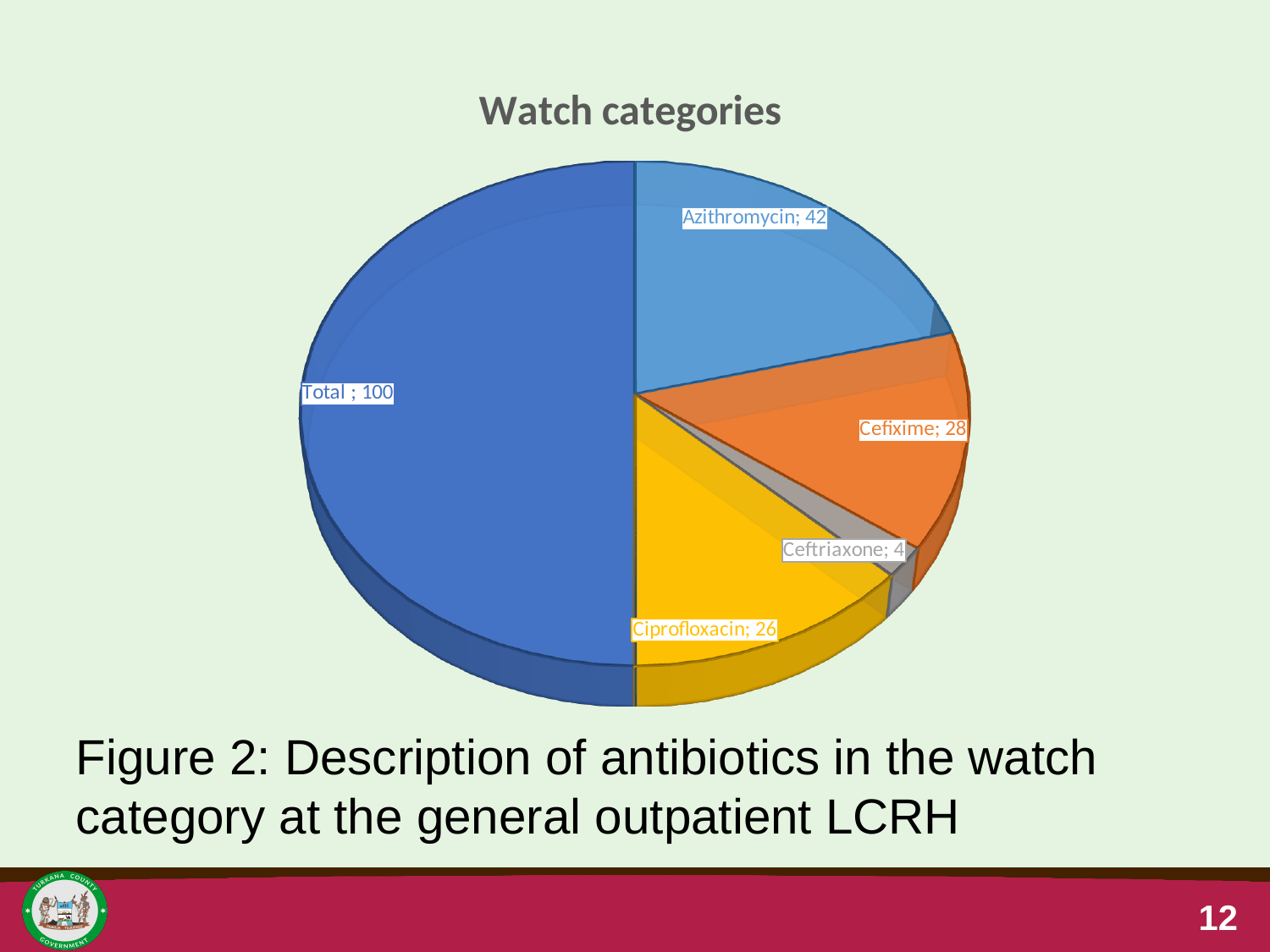
What is the value shown for Ceftriaxone? 4 What is the difference between the values for Azithromycin and Ciprofloxacin? 16 Which slice has the smallest value? Ceftriaxone What is the value shown for the slice labelled Total? 100 What is the value shown for Ciprofloxacin? 26 How many slices does the pie chart have? 5 What is the value shown for Azithromycin? 42 What is the title of the chart? Watch categories Which slice has the largest value? Total Which is larger, the value for Azithromycin or the value for Cefixime? Azithromycin What is the value shown for Cefixime? 28 What kind of chart is shown on the slide? pie chart